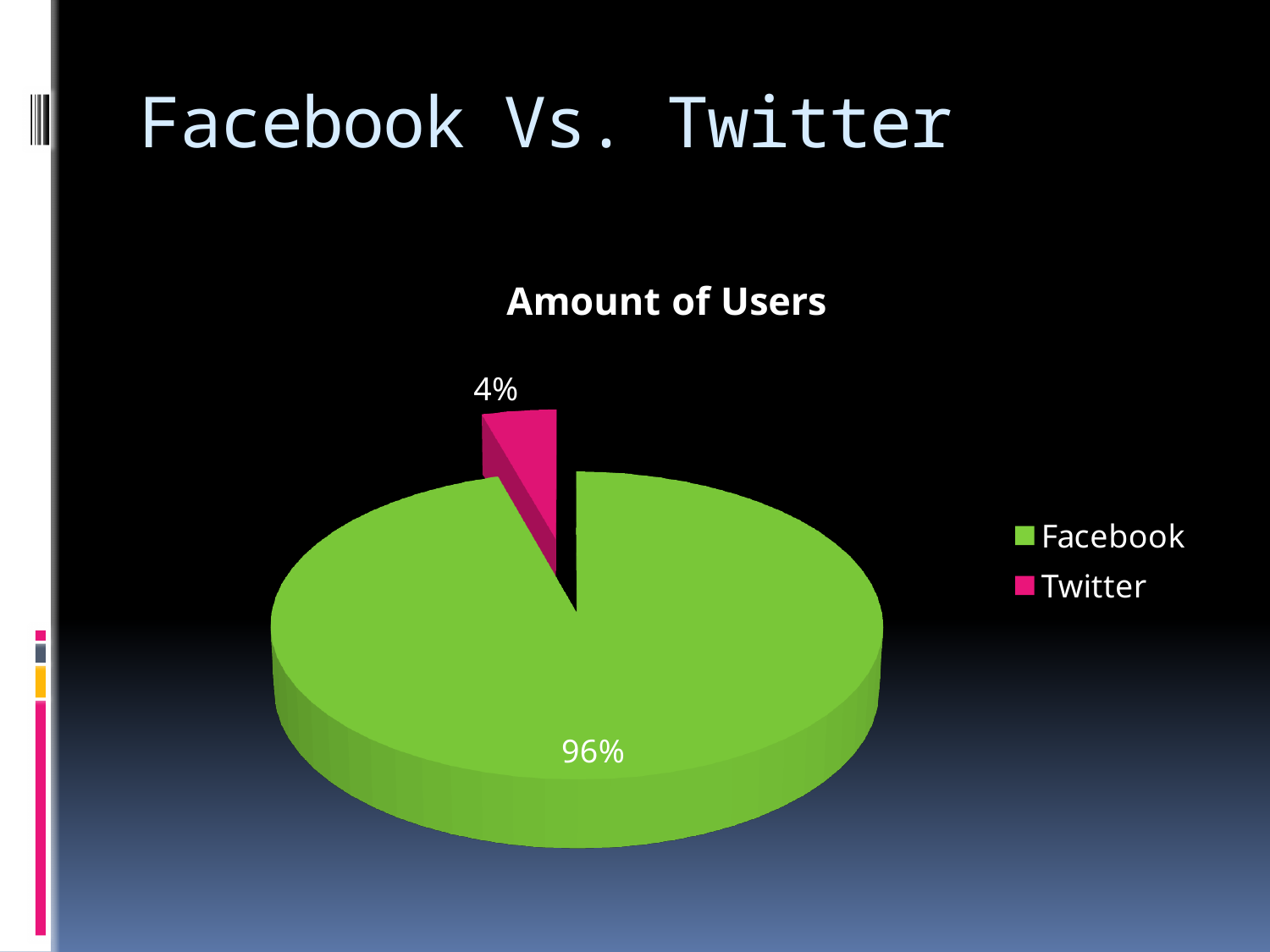
How many categories are shown in the pie chart? 2 What is the title of the chart? Amount of Users What share of the pie does Twitter account for? 4% What colour is the Twitter slice in the pie chart? Pink What is the difference in percentage points between the Facebook and Twitter slices? 92 What type of chart is shown on the slide? Pie chart Which category has the smallest slice of the pie? Twitter How many entries does the legend list? 2 What share of the pie does Facebook account for? 96% Which category has the largest slice of the pie? Facebook Which is larger, the Facebook slice or the Twitter slice? Facebook